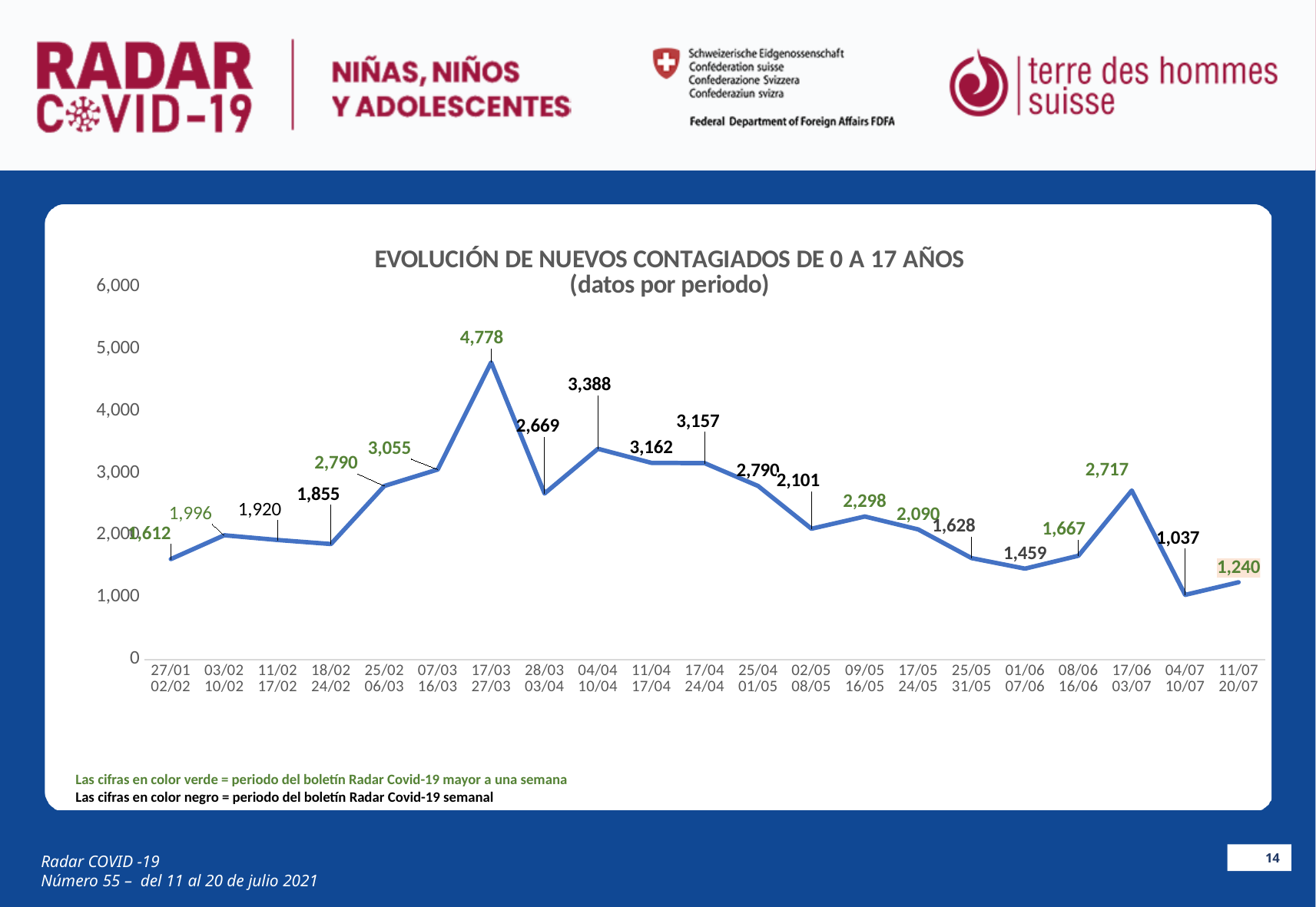
What is the value for the period 11/07–20/07? 1,240 Which is larger, the value for 17/06–03/07 or the value for 04/07–10/07? 17/06–03/07 What is the value for the period 04/04–10/04? 3,388 What type of chart is shown on the slide? line chart How many periods (data points) are plotted on the chart? 21 What is the difference between the values for 17/03–27/03 and 28/03–03/04? 2,109 Which period has the lowest value? 04/07–10/07 What is the value for the period 17/03–27/03? 4,778 Is the value for 07/03–16/03 greater or less than 3,000? greater Which period has the highest value? 17/03–27/03 Do the values rise or fall from 17/03–27/03 to 28/03–03/04? fall What is the title of the chart? EVOLUCIÓN DE NUEVOS CONTAGIADOS DE 0 A 17 AÑOS (datos por periodo)